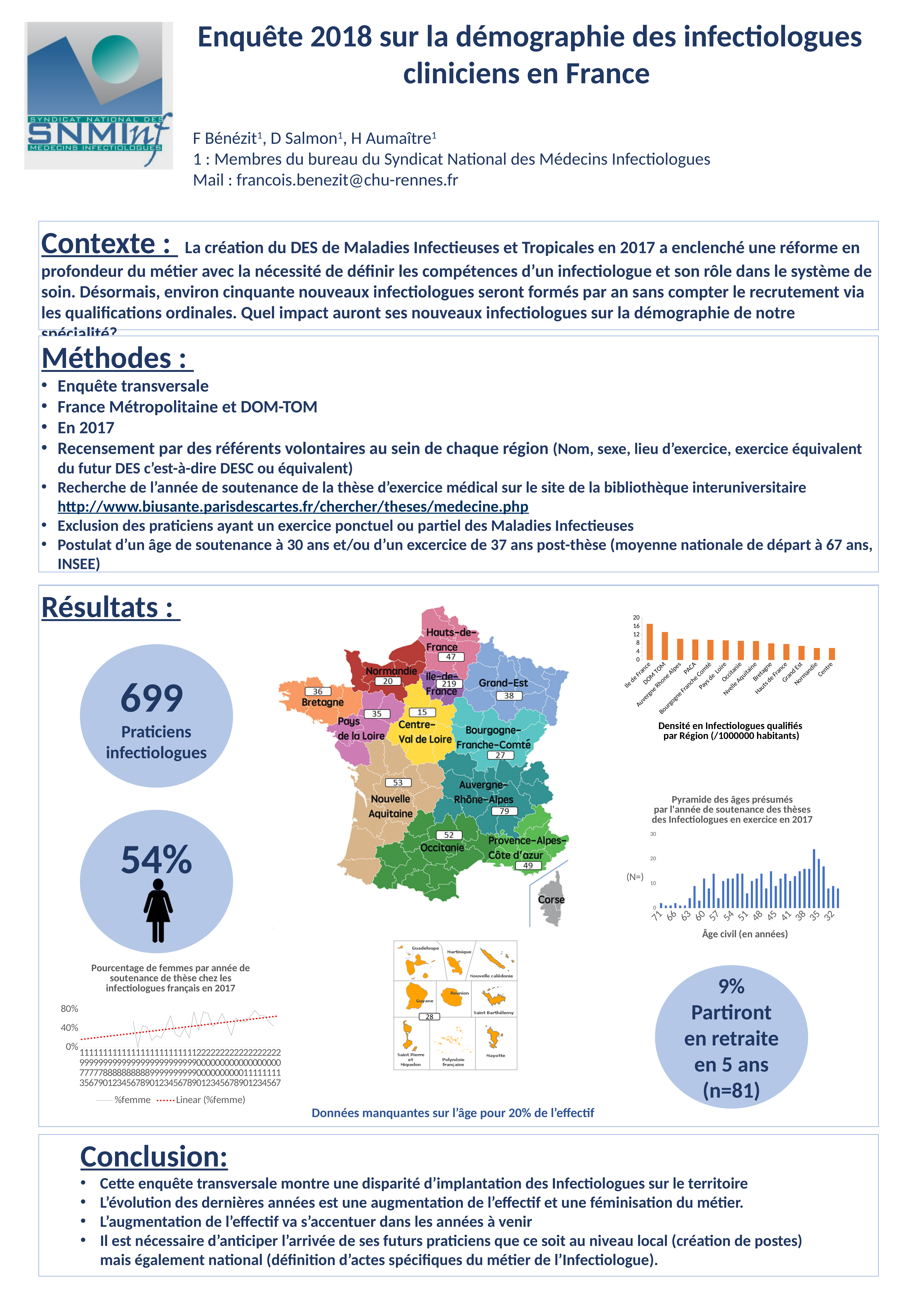
What kind of chart is the 'Pourcentage de femmes par année de soutenance de thèse' chart? line chart In the 'Densité en Infectiologues qualifiés par Région' chart, do the values rise or fall from left to right? fall In the 'Densité en Infectiologues qualifiés par Région' chart, which is larger, the value for DOM TOM or the value for Bretagne? DOM TOM In the 'Densité en Infectiologues qualifiés par Région' chart, is the value for Centre greater or less than 8? less What kind of chart is the 'Pyramide des âges présumés' chart? bar chart In the 'Pyramide des âges présumés' chart, is the tallest bar greater or less than 20? greater In the 'Densité en Infectiologues qualifiés par Région' chart, is the value for Ile de France greater or less than 12? greater How many series does the legend of the 'Pourcentage de femmes par année de soutenance de thèse' chart list? 2 In the 'Densité en Infectiologues qualifiés par Région' chart, which region has the highest density? Ile de France How many regions are shown in the 'Densité en Infectiologues qualifiés par Région' chart? 13 What kind of chart is the 'Densité en Infectiologues qualifiés par Région' chart? bar chart What is the x-axis label of the 'Pyramide des âges présumés' chart? Âge civil (en années)